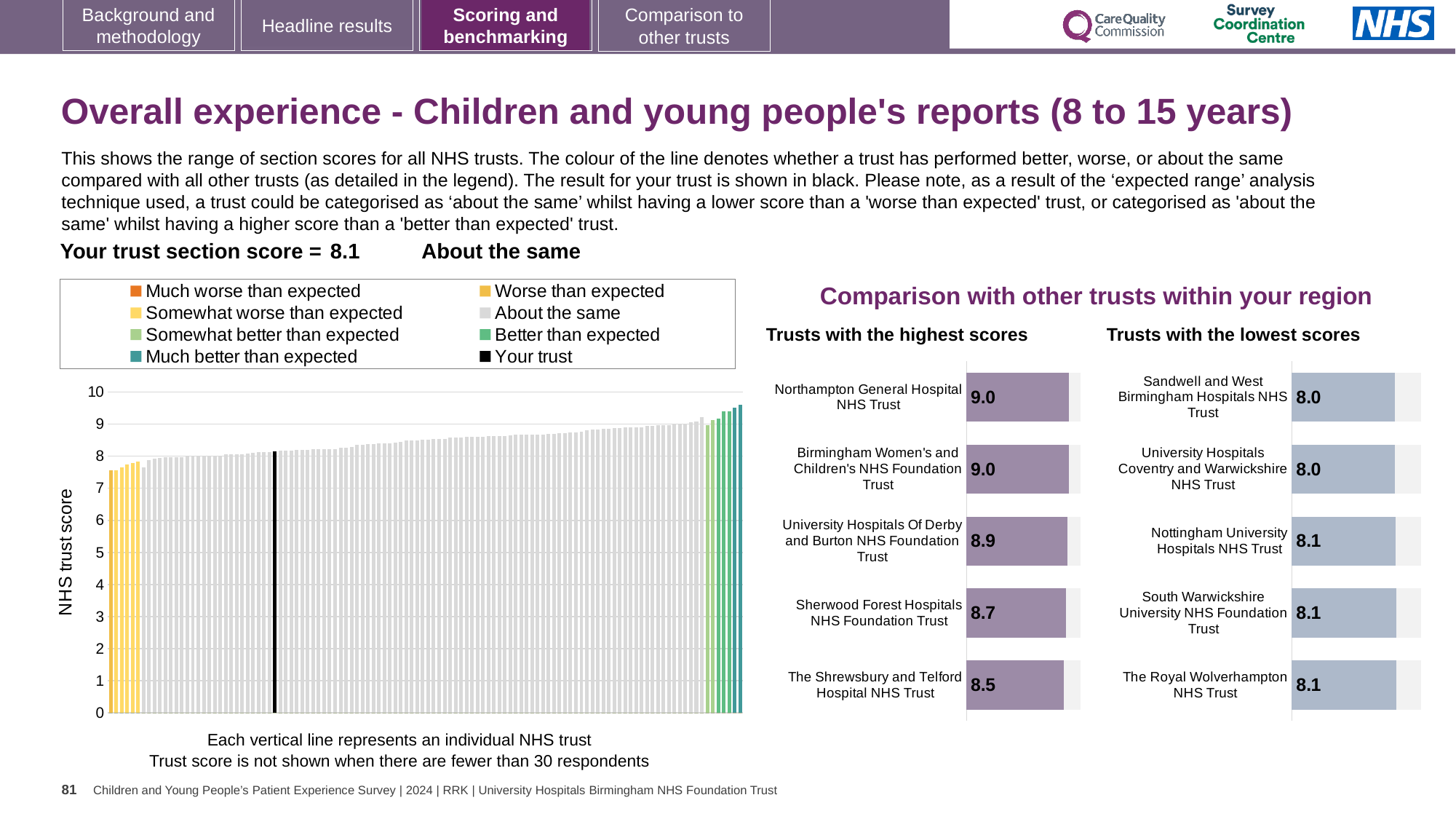
In the 'Trusts with the highest scores' chart, which trust has the lowest score? The Shrewsbury and Telford Hospital NHS Trust What type of chart is the large chart on the left showing NHS trust scores? Bar chart In the 'Trusts with the highest scores' chart, which has the higher score: University Hospitals Of Derby and Burton NHS Foundation Trust or Sherwood Forest Hospitals NHS Foundation Trust? University Hospitals Of Derby and Burton NHS Foundation Trust In the 'Trusts with the highest scores' chart, what is the score for Sherwood Forest Hospitals NHS Foundation Trust? 8.7 How many trusts are shown in the 'Trusts with the lowest scores' chart? 5 In the 'Trusts with the lowest scores' chart, what is the difference between the scores of The Royal Wolverhampton NHS Trust and Sandwell and West Birmingham Hospitals NHS Trust? 0.1 What is the section score for your trust shown on the slide? 8.1 In the large chart on the left, do the trust scores rise or fall from left to right? Rise In the 'Trusts with the lowest scores' chart, what is the score for Nottingham University Hospitals NHS Trust? 8.1 In the 'Trusts with the highest scores' chart, what is the difference between the scores of Northampton General Hospital NHS Trust and The Shrewsbury and Telford Hospital NHS Trust? 0.5 How many entries does the legend of the large chart on the left list? 8 In the large chart on the left, is the value of the lowest bar greater or less than 7? greater